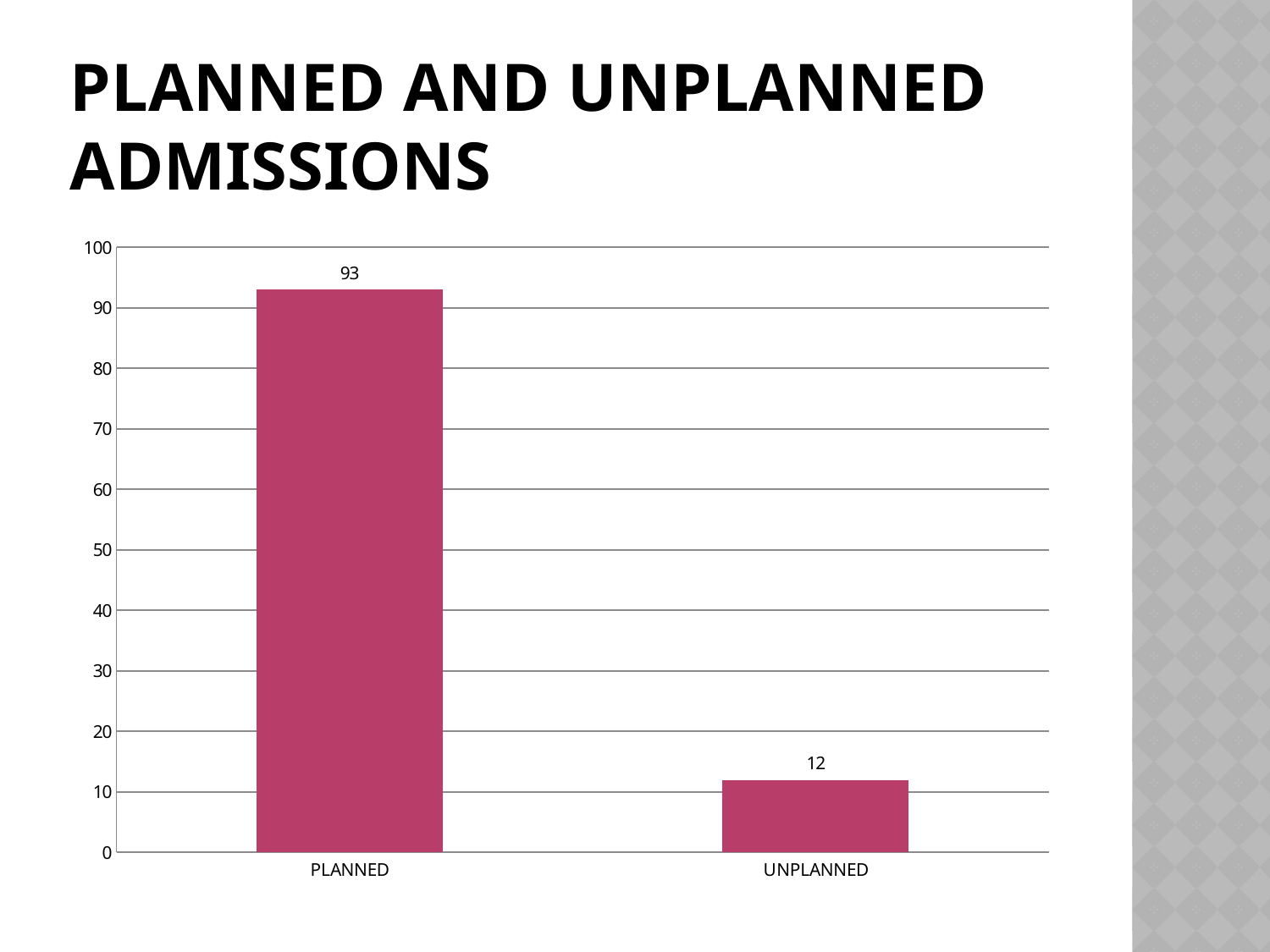
What kind of chart is shown on the slide? bar chart What is the maximum value shown on the vertical axis? 100 Is the value for UNPLANNED greater or less than 20? less Is the value for PLANNED greater or less than 90? greater Which category has the lowest value? UNPLANNED Which category has the highest value? PLANNED What is the value for PLANNED admissions? 93 What is the difference between the PLANNED and UNPLANNED values? 81 Which is larger, PLANNED or UNPLANNED? PLANNED What is the title of the slide containing the chart? PLANNED AND UNPLANNED ADMISSIONS How many categories are shown on the x axis? 2 What is the value for UNPLANNED admissions? 12